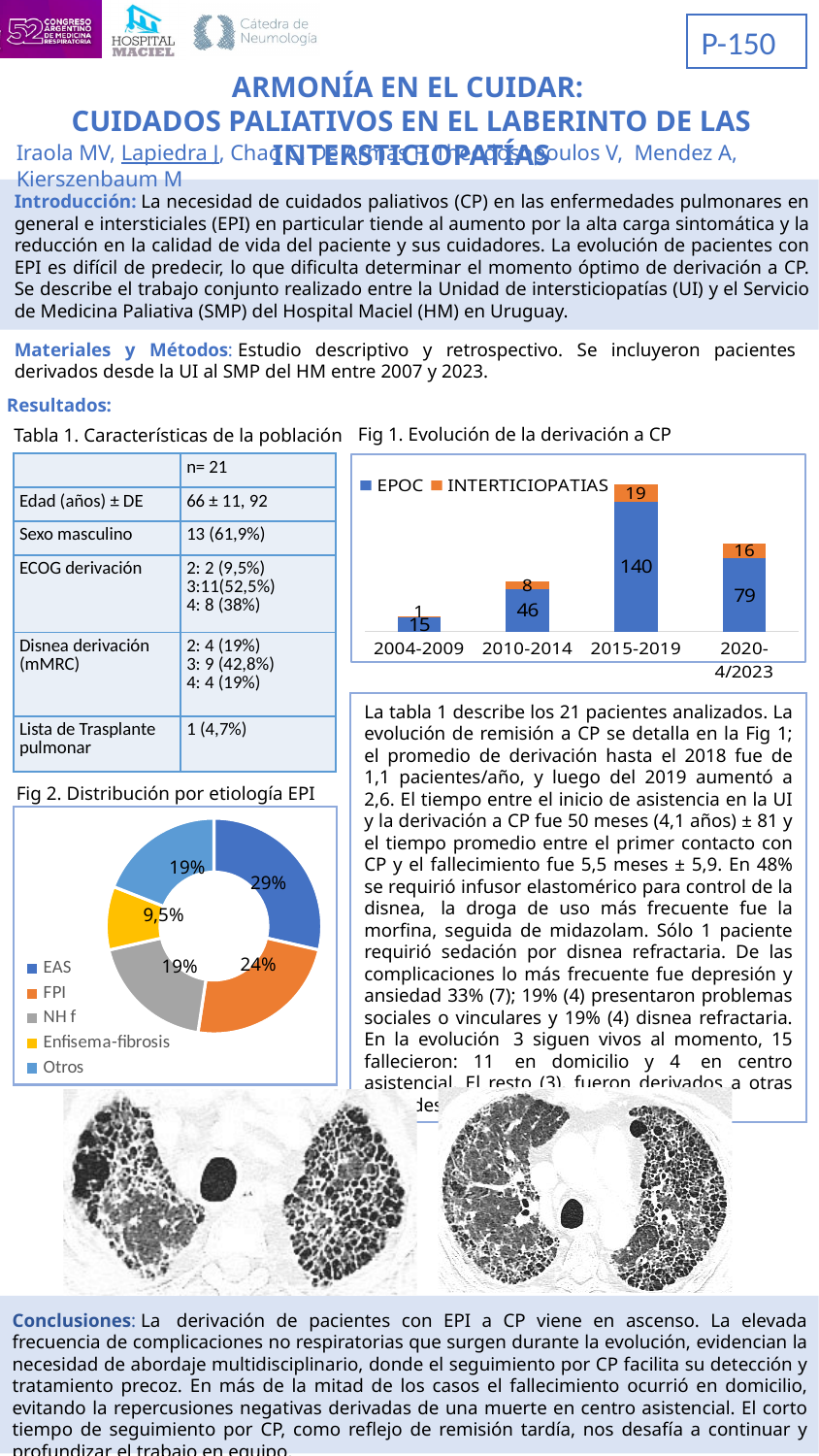
In Fig 2 (Distribución por etiología EPI), how many categories does the legend list? 5 In Fig 1 (Evolución de la derivación a CP), which period has the highest EPOC value? 2015-2019 In Fig 1 (Evolución de la derivación a CP), how many series does the legend list? 2 In Fig 1 (Evolución de la derivación a CP), what is the EPOC value for 2020-4/2023? 79 In Fig 1 (Evolución de la derivación a CP), which period has the lowest INTERTICIOPATIAS value? 2004-2009 What kind of chart is Fig 1 (Evolución de la derivación a CP)? Stacked bar chart In Fig 2 (Distribución por etiología EPI), which etiology has the smallest share? Enfisema-fibrosis In Fig 1 (Evolución de la derivación a CP), what is the EPOC value for 2015-2019? 140 In Fig 1 (Evolución de la derivación a CP), what is the INTERTICIOPATIAS value for 2010-2014? 8 In Fig 2 (Distribución por etiología EPI), what share does EAS have? 29% In Fig 1 (Evolución de la derivación a CP), what is the difference between the EPOC values for 2015-2019 and 2020-4/2023? 61 In Fig 1 (Evolución de la derivación a CP), what is the total of the stacked bar for 2015-2019? 159